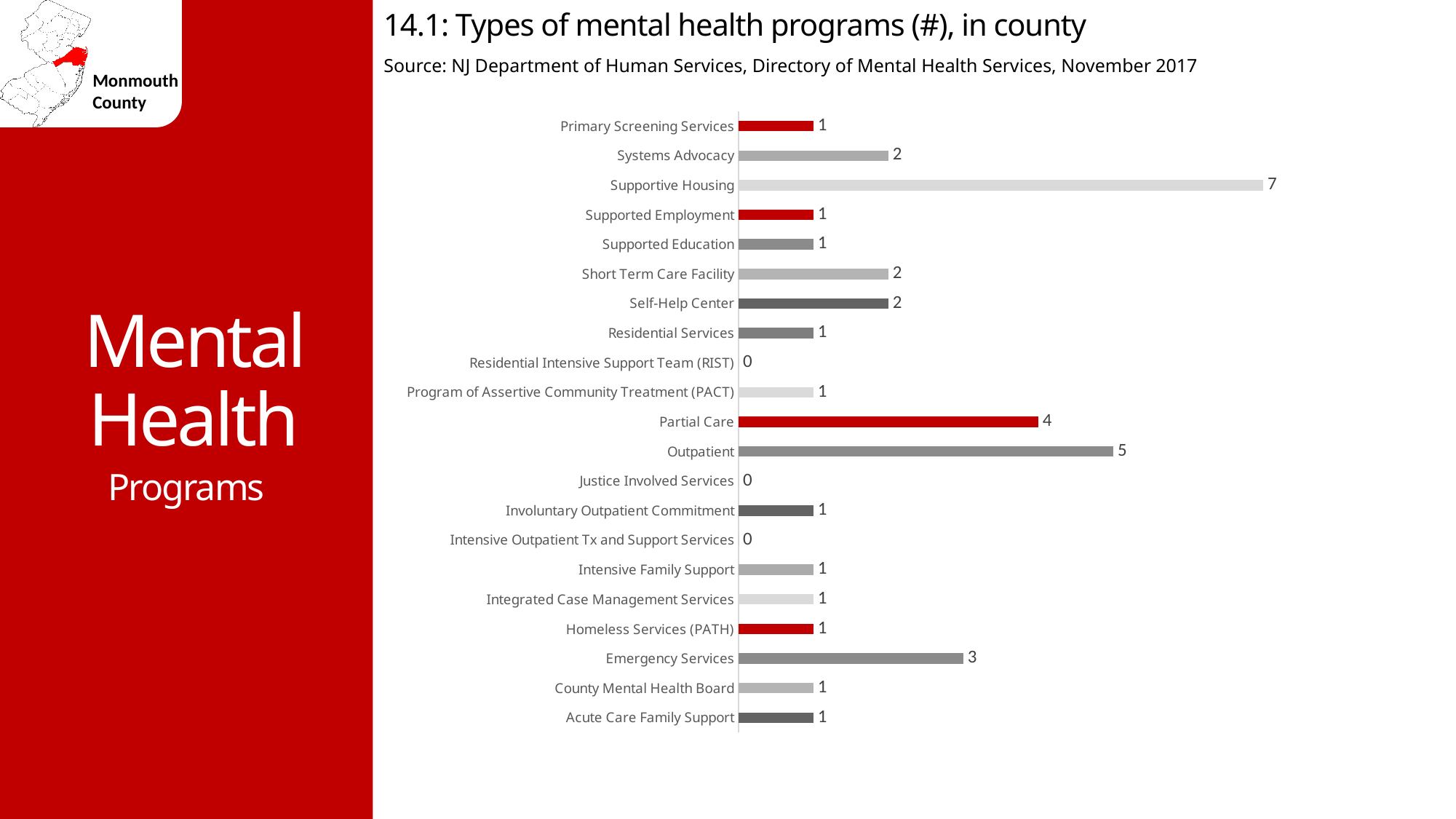
How many program types have a value of 0? 3 What is the value for Residential Intensive Support Team (RIST)? 0 How many mental health programs are shown for Supportive Housing? 7 What is the value for Emergency Services? 3 Which has a larger value, Partial Care or Emergency Services? Partial Care What is the difference between the values for Supportive Housing and Outpatient? 2 What kind of chart is shown on the slide? Bar chart Which type of mental health program has the highest count? Supportive Housing What is the source cited for the chart? NJ Department of Human Services, Directory of Mental Health Services, November 2017 What is the value for Outpatient? 5 What is the value for Partial Care? 4 How many program types are listed on the chart? 21